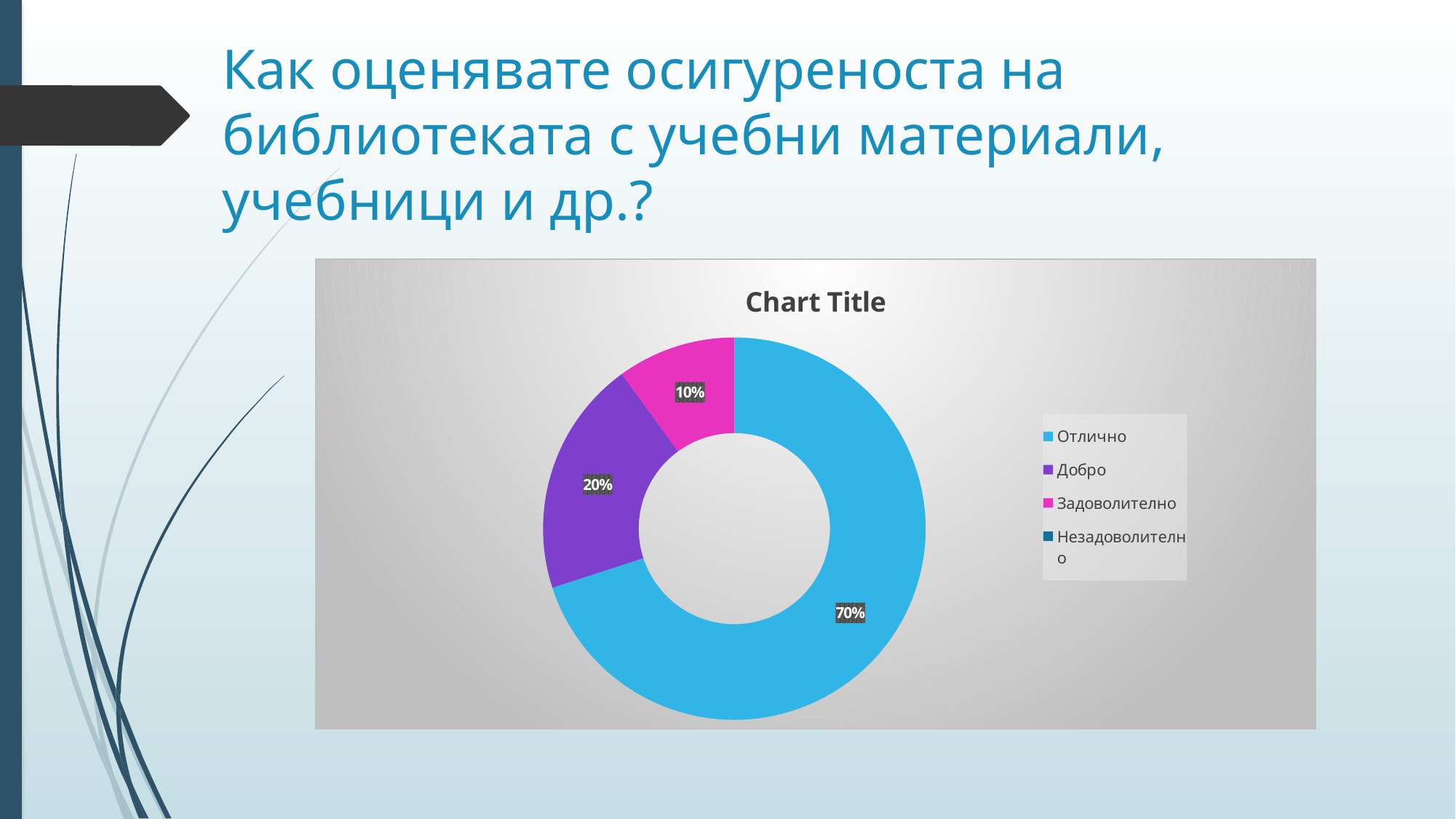
How many entries does the legend list? 4 Which of the slices with a printed label is the smallest? Задоволително What is the difference in percentage points between Отлично and Добро? 50 What percentage is shown for Отлично? 70% How many slices with printed data labels are visible in the doughnut? 3 What kind of chart is shown on the slide? Doughnut chart What colour is the slice for Задоволително? Pink (magenta) Which category has the largest share of the doughnut? Отлично What percentage is shown for Добро? 20% What percentage is shown for Задоволително? 10% What is the title shown above the chart? Chart Title Which is larger, the share for Добро or the share for Задоволително? Добро